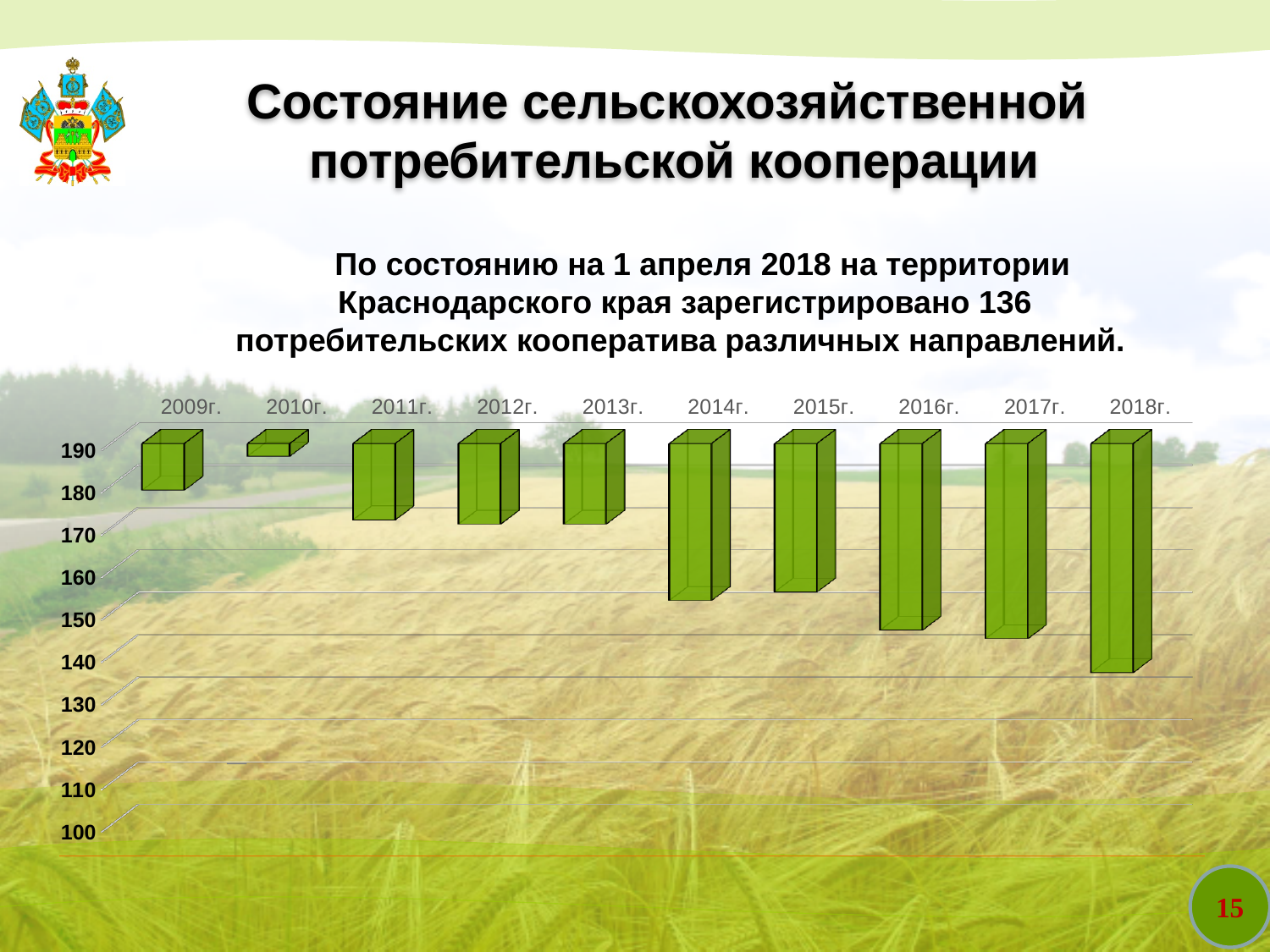
Which has the larger value, 2009г. or 2018г.? 2009г. What is the last year shown on the chart's x axis? 2018г. What is the first year shown on the chart's x axis? 2009г. Is the value for 2018г. greater or less than 150? less What kind of chart is shown on the slide? bar chart Is the value for 2016г. greater or less than 160? less Is the value for 2009г. greater or less than 170? greater What is the lowest value shown on the chart's vertical axis? 100 Do the values rise or fall from 2009г. to 2018г.? fall How many years (categories) are shown on the chart? 10 Which year has the lowest value on the chart? 2018г.